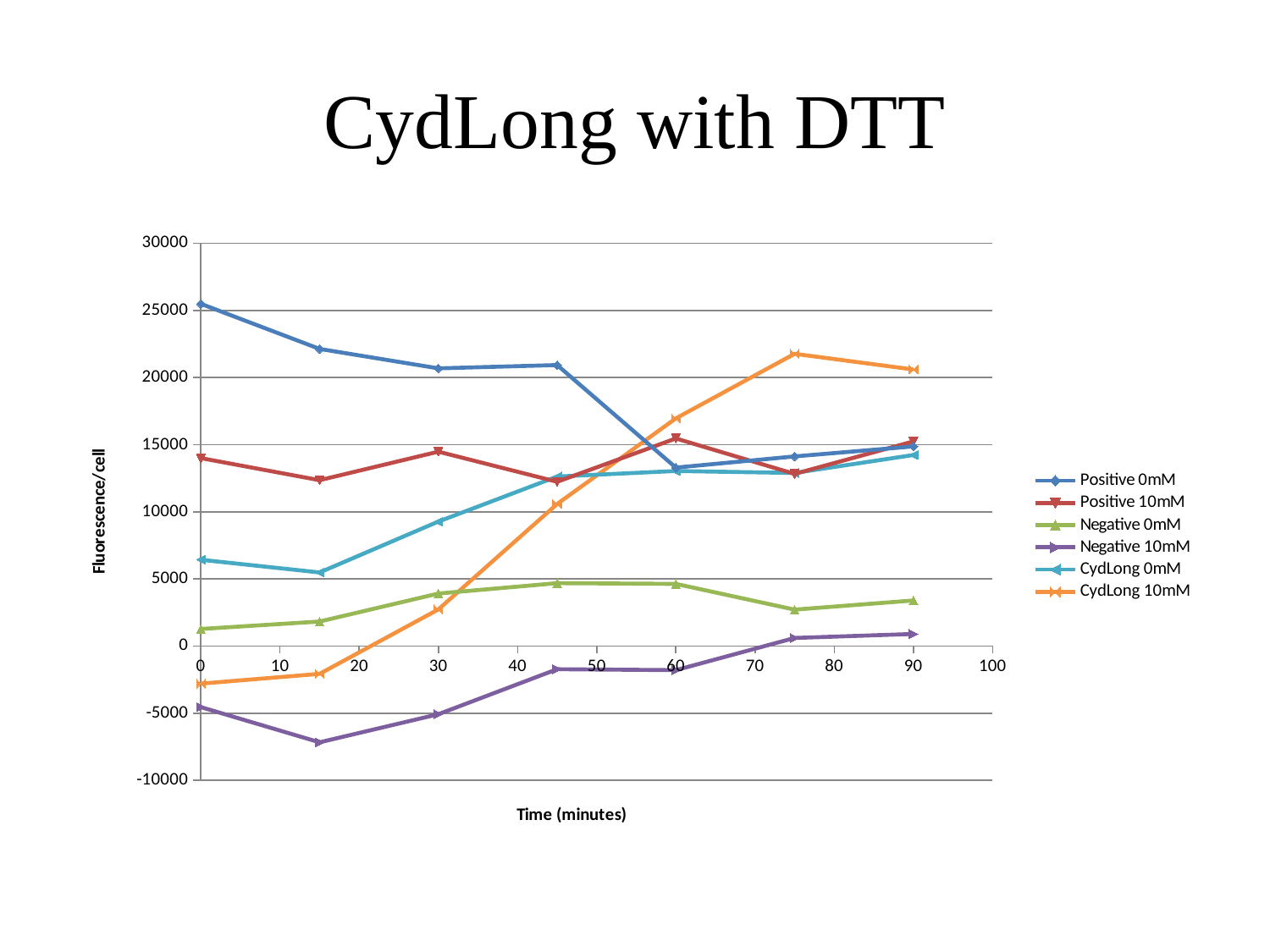
Which series has the lowest value at 0 minutes? Negative 10mM What kind of chart is shown on the slide? line chart Is the value for Positive 0mM at 0 minutes greater or less than 20000? greater Is the value for Positive 10mM at 0 minutes greater or less than 15000? less At 0 minutes, which is larger: Positive 0mM or Positive 10mM? Positive 0mM Which series has the highest value at 90 minutes? CydLong 10mM How many series does the legend list? 6 Is the value for Negative 10mM at 15 minutes greater or less than -5000? less Does the CydLong 10mM series rise or fall between 0 and 75 minutes? rise What is the label of the y axis? Fluorescence/cell How many time points are plotted for each series? 7